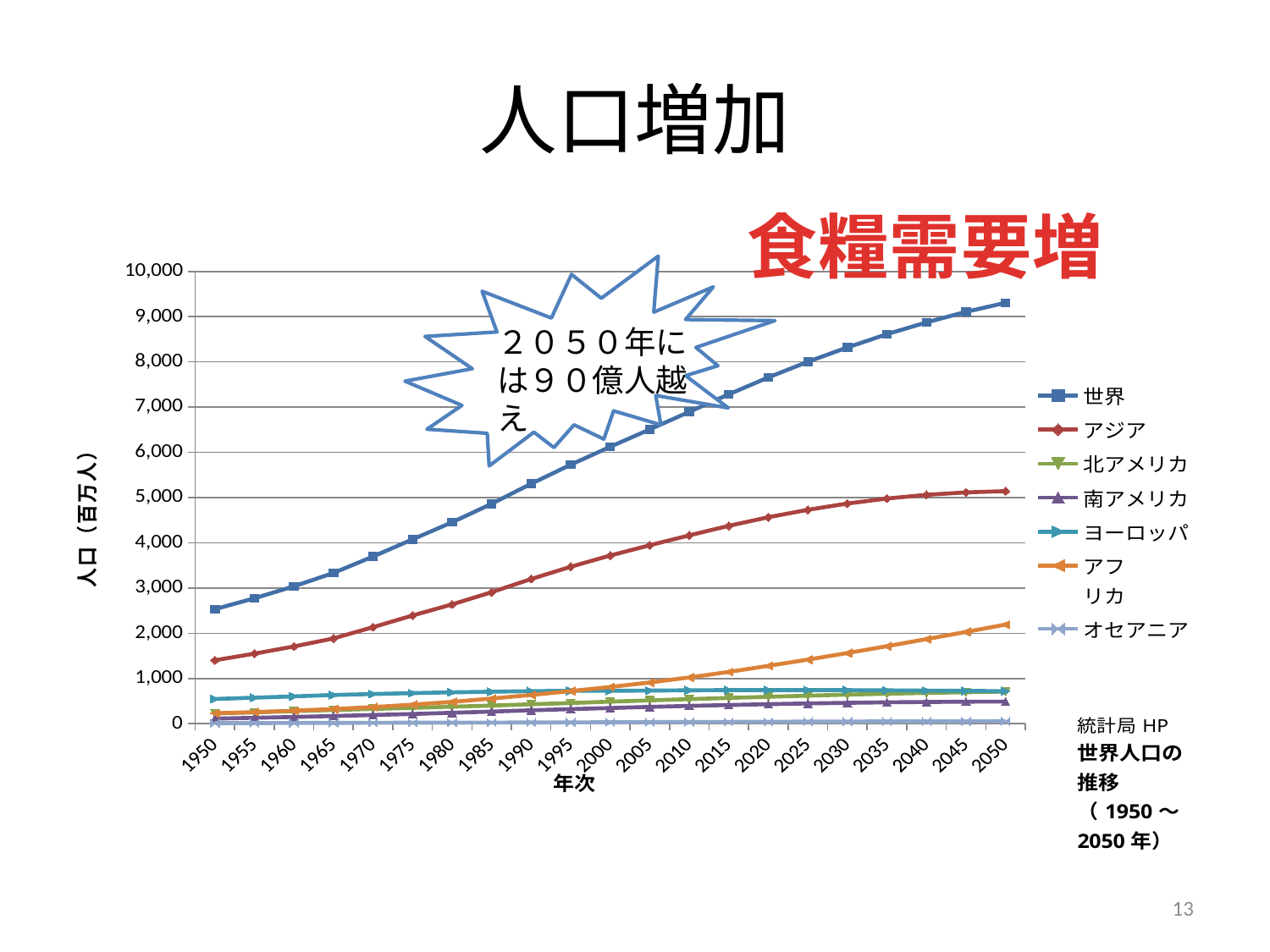
Is the value for 世界 in 1950 greater or less than 3,000? less How many years are marked along the x axis? 21 How many series does the legend list? 7 What kind of chart is shown on the slide? line chart Which series has the highest value in 2050? 世界 In 2050, which is larger, アジア or アフリカ? アジア Which series has the lowest value in 2050? オセアニア What is the label of the y axis? 人口（百万人） Is the value for ヨーロッパ in 2050 greater or less than 1,000? less Does the 世界 series rise or fall from 1950 to 2050? rise Is the value for アジア in 2050 greater or less than 5,000? greater